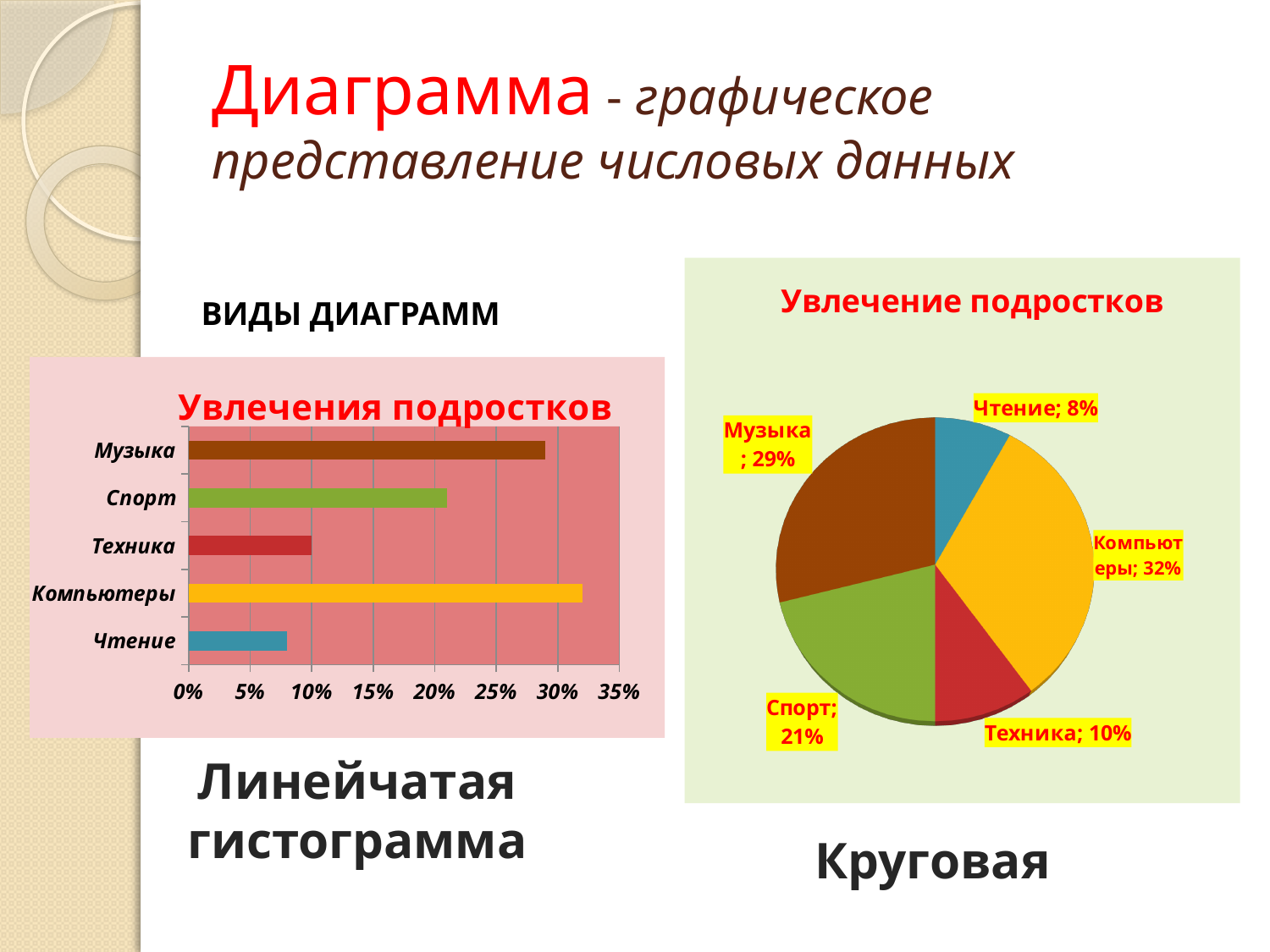
In the pie chart "Увлечение подростков", what is the difference between the shares for Музыка and Спорт? 8% In the pie chart "Увлечение подростков", which category has the largest share? Компьютеры In the pie chart "Увлечение подростков", what is the share for Компьютеры? 32% In the bar chart "Увлечения подростков", is the value for Компьютеры greater or less than 30%? greater In the pie chart "Увлечение подростков", what is the share for Чтение? 8% In the pie chart "Увлечение подростков", which category has the smallest share? Чтение What kind of chart is the left chart titled "Увлечения подростков"? bar chart In the bar chart "Увлечения подростков", how many categories are shown? 5 In the pie chart "Увлечение подростков", how many slices are there? 5 What kind of chart is the right chart titled "Увлечение подростков"? pie chart In the bar chart "Увлечения подростков", which is larger, the value for Музыка or the value for Спорт? Музыка In the bar chart "Увлечения подростков", is the value for Чтение greater or less than 10%? less